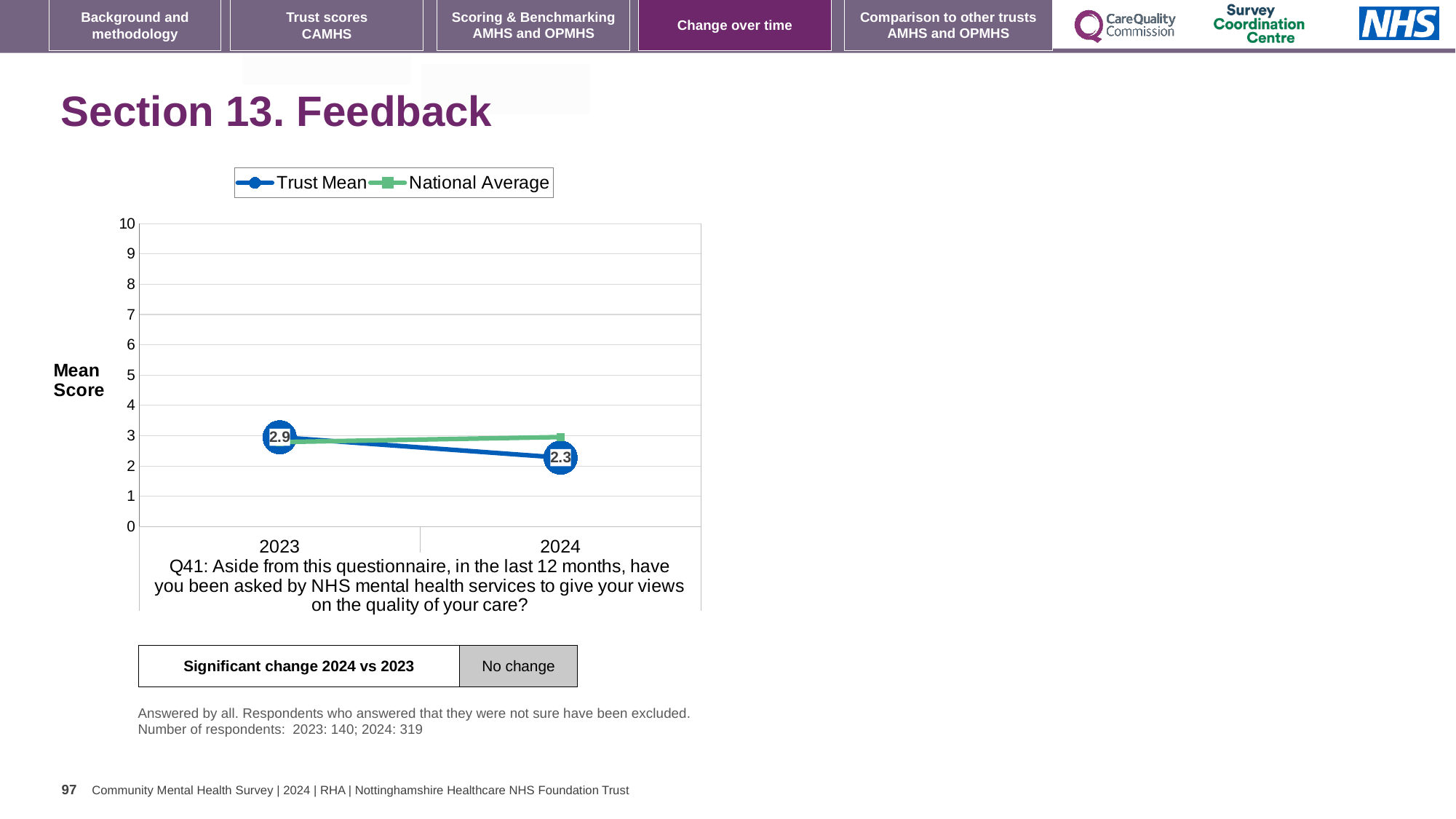
Does the Trust Mean rise or fall from 2023 to 2024? Fall How many years are plotted on the x axis? 2 In which year is the Trust Mean score highest? 2023 What kind of chart is shown on the slide? Line chart In which year is the Trust Mean score lowest? 2024 How many series does the legend list? 2 Which is larger in 2024, the Trust Mean or the National Average? National Average Is the National Average value for 2024 greater or less than 2? greater What is the difference between the Trust Mean score in 2023 and in 2024? 0.6 What is the Trust Mean score for 2024? 2.3 What is the Trust Mean score for 2023? 2.9 Is the National Average value for 2023 greater or less than 4? less